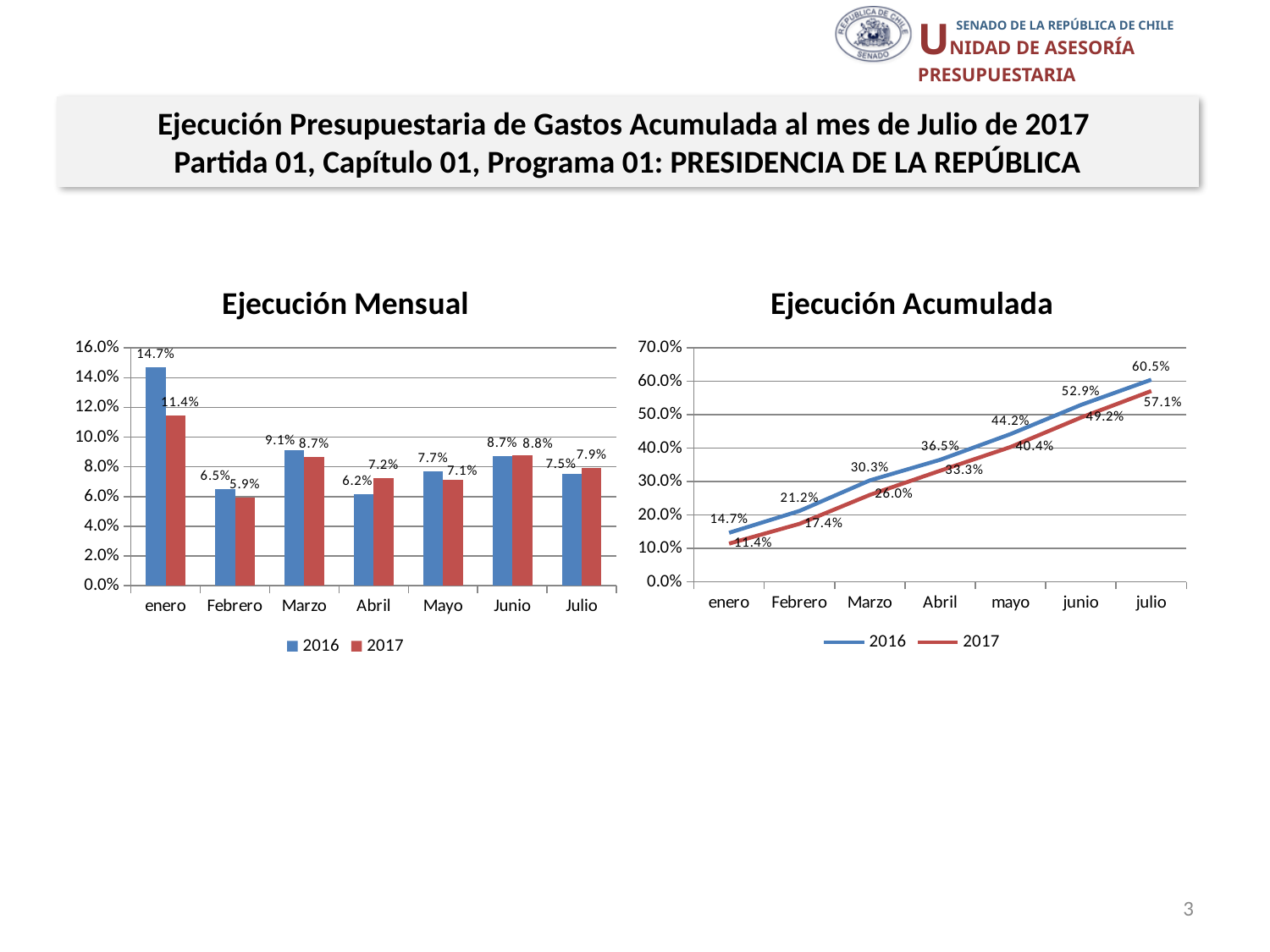
In the 'Ejecución Mensual' chart, what is the value for 2016 in Abril? 6.2% In the 'Ejecución Mensual' chart, which month has the highest value for 2016? enero In the 'Ejecución Mensual' chart, what is the difference between the 2016 and 2017 values in enero? 3.3% How many series does the legend of the 'Ejecución Acumulada' chart list? 2 In the 'Ejecución Acumulada' chart, what is the value for 2017 in julio? 57.1% In the 'Ejecución Mensual' chart, what is the value for 2017 in enero? 11.4% In the 'Ejecución Mensual' chart, which month has the lowest value for 2017? Febrero In the 'Ejecución Acumulada' chart, what is the difference between the 2016 and 2017 values in junio? 3.7% In the 'Ejecución Acumulada' chart, what is the value for 2016 in mayo? 44.2% In the 'Ejecución Acumulada' chart, do the values for 2016 rise or fall from enero to julio? Rise In the 'Ejecución Mensual' chart, which is larger in Marzo, the 2016 value or the 2017 value? 2016 What kind of chart is 'Ejecución Mensual'? Bar chart